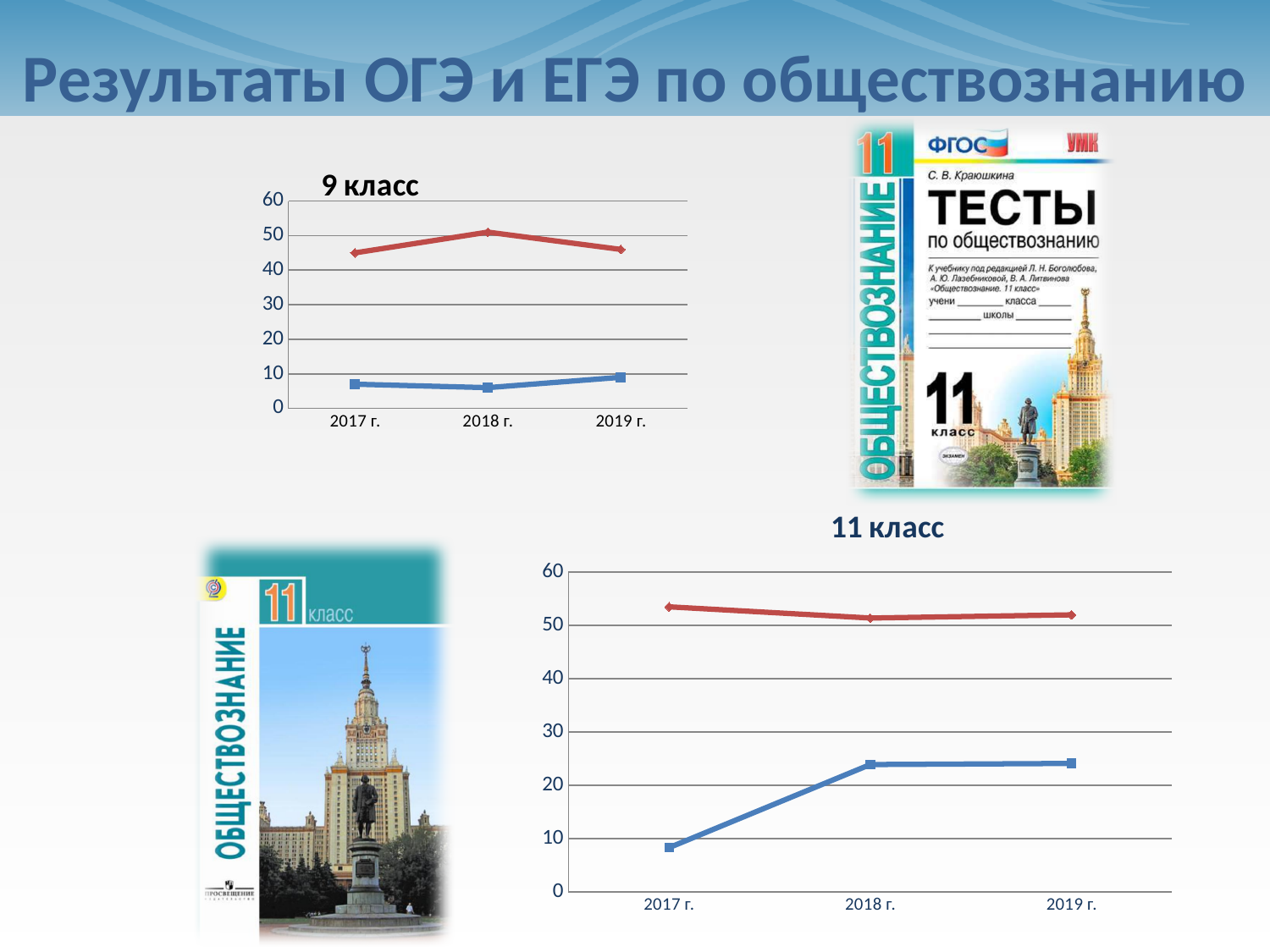
In the "11 класс" chart, does the blue line rise or fall from 2017 г. to 2018 г.? rises In the "11 класс" chart, is the value of the red line for 2017 г. greater or less than 50? greater How many lines are plotted on the "11 класс" chart? 2 What kind of chart is the "9 класс" chart? line chart In the "9 класс" chart, in which year does the red line reach its highest value? 2018 г. In the "9 класс" chart, is the value of the red line for 2017 г. greater or less than 40? greater How many years are shown on the x axis of the "9 класс" chart? 3 In the "9 класс" chart, in which year does the blue line reach its lowest value? 2018 г. In the "11 класс" chart, is the value of the blue line for 2018 г. greater or less than 20? greater In the "11 класс" chart, which line has the higher value in 2019 г., the red line or the blue line? the red line